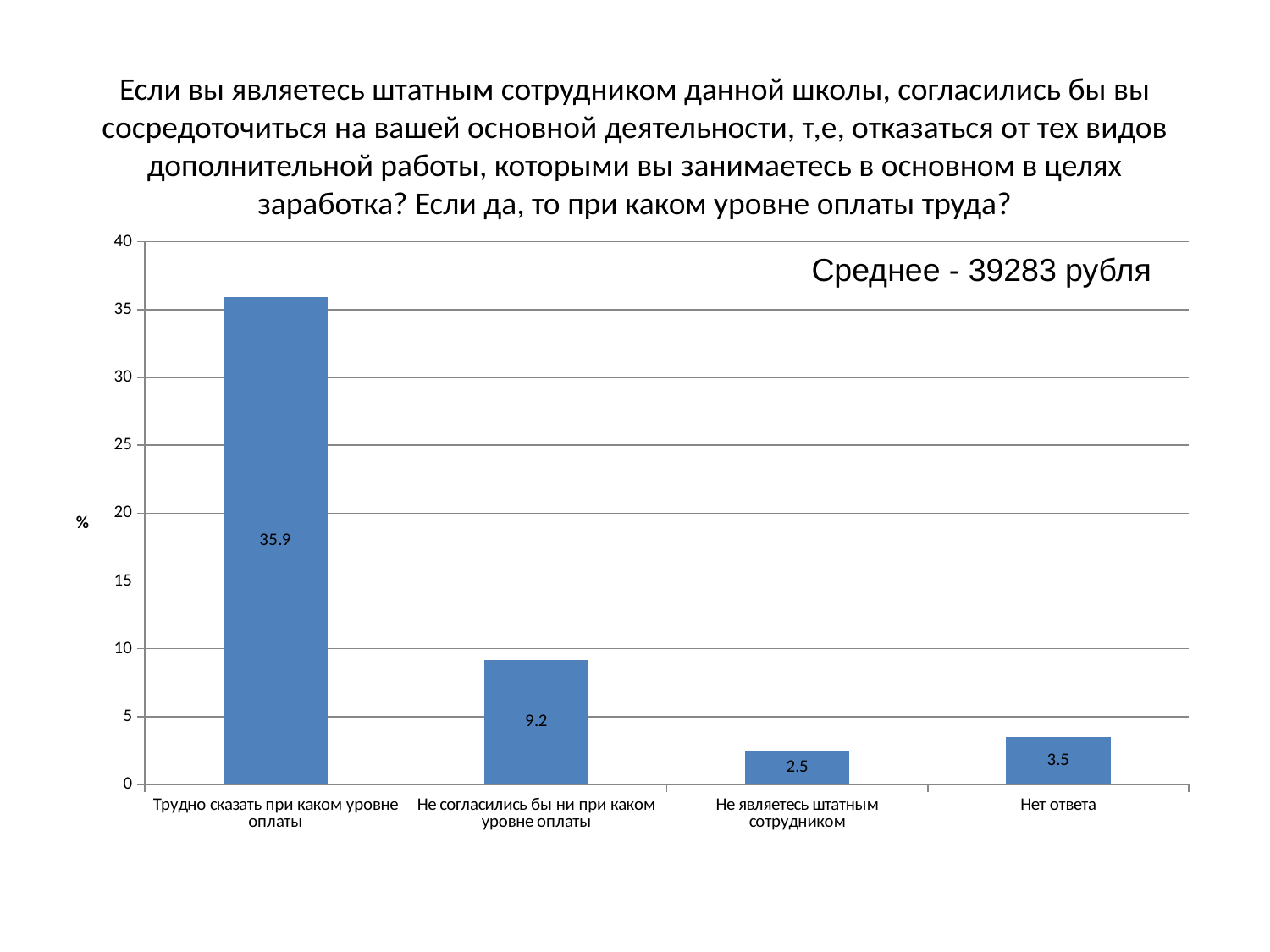
What is the value for "Не являетесь штатным сотрудником"? 2.5 What is the value for "Трудно сказать при каком уровне оплаты"? 35.9 Which category has the highest value? Трудно сказать при каком уровне оплаты Which is larger: the value for "Нет ответа" or the value for "Не являетесь штатным сотрудником"? Нет ответа What average value (Среднее) is stated on the chart? 39283 рубля What is the value for "Не согласились бы ни при каком уровне оплаты"? 9.2 What kind of chart is shown on the slide? bar chart What is the value for "Нет ответа"? 3.5 Is the value for "Не согласились бы ни при каком уровне оплаты" greater or less than 10? less What is the difference between the values for "Трудно сказать при каком уровне оплаты" and "Не согласились бы ни при каком уровне оплаты"? 26.7 How many categories are shown on the chart? 4 Which category has the lowest value? Не являетесь штатным сотрудником